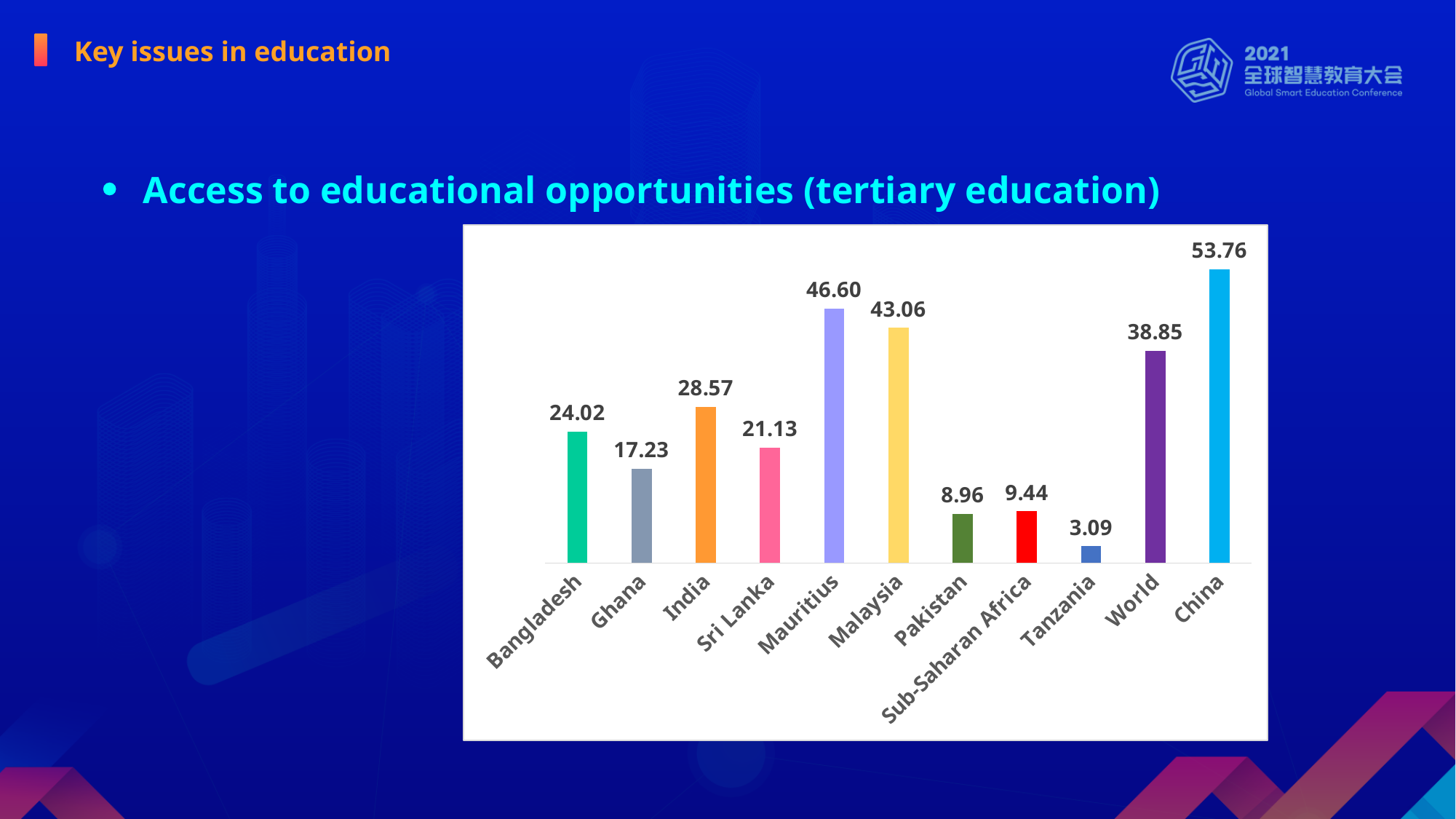
Which category has the lowest value? Tanzania Which is larger, the value for Pakistan or the value for Sri Lanka? Sri Lanka What kind of chart is shown on the slide? Bar chart What is the value for Sub-Saharan Africa? 9.44 What is the value for Mauritius? 46.60 What is the value for Bangladesh? 24.02 What is the value for World? 38.85 Which is larger, the value for Malaysia or the value for Mauritius? Mauritius What is the difference between the values for China and World? 14.91 Which category has the highest value? China How many categories are shown on the x axis? 11 What is the difference between the values for India and Ghana? 11.34